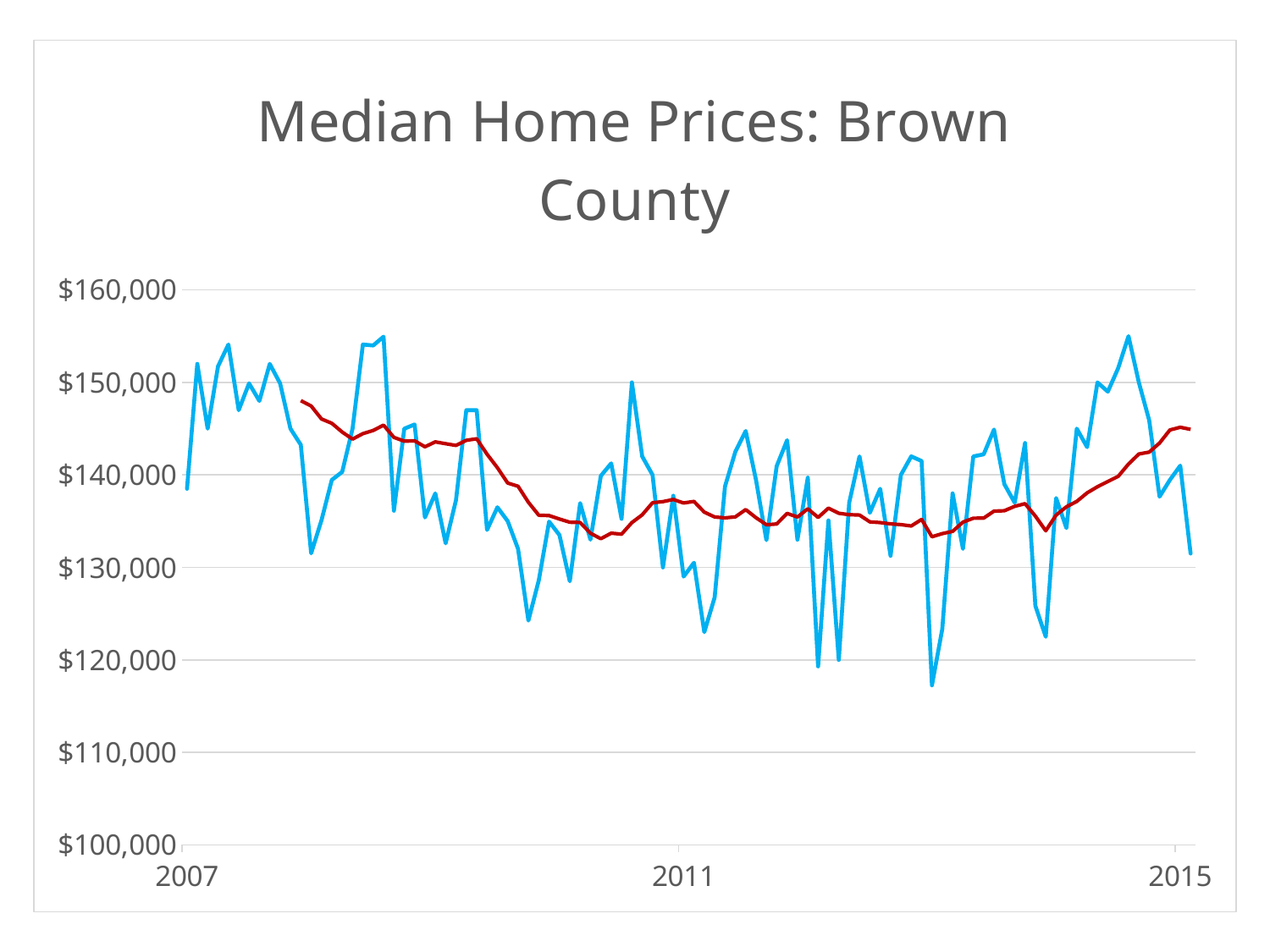
Is the value of the blue line at the start of 2007 greater or less than $130,000? greater Is the highest point of the blue line greater or less than $150,000? greater Is the value of the red line at 2011 greater or less than $140,000? less Which line is smoother, the blue line or the red line? the red line How many lines are plotted on the chart? 2 What colours are the two lines on the chart? blue and red What is the title of the chart? Median Home Prices: Brown County What kind of chart is shown on the slide? line chart Does the red line rise or fall between 2011 and 2015? rise Does the red line rise or fall between 2007 and 2011? fall